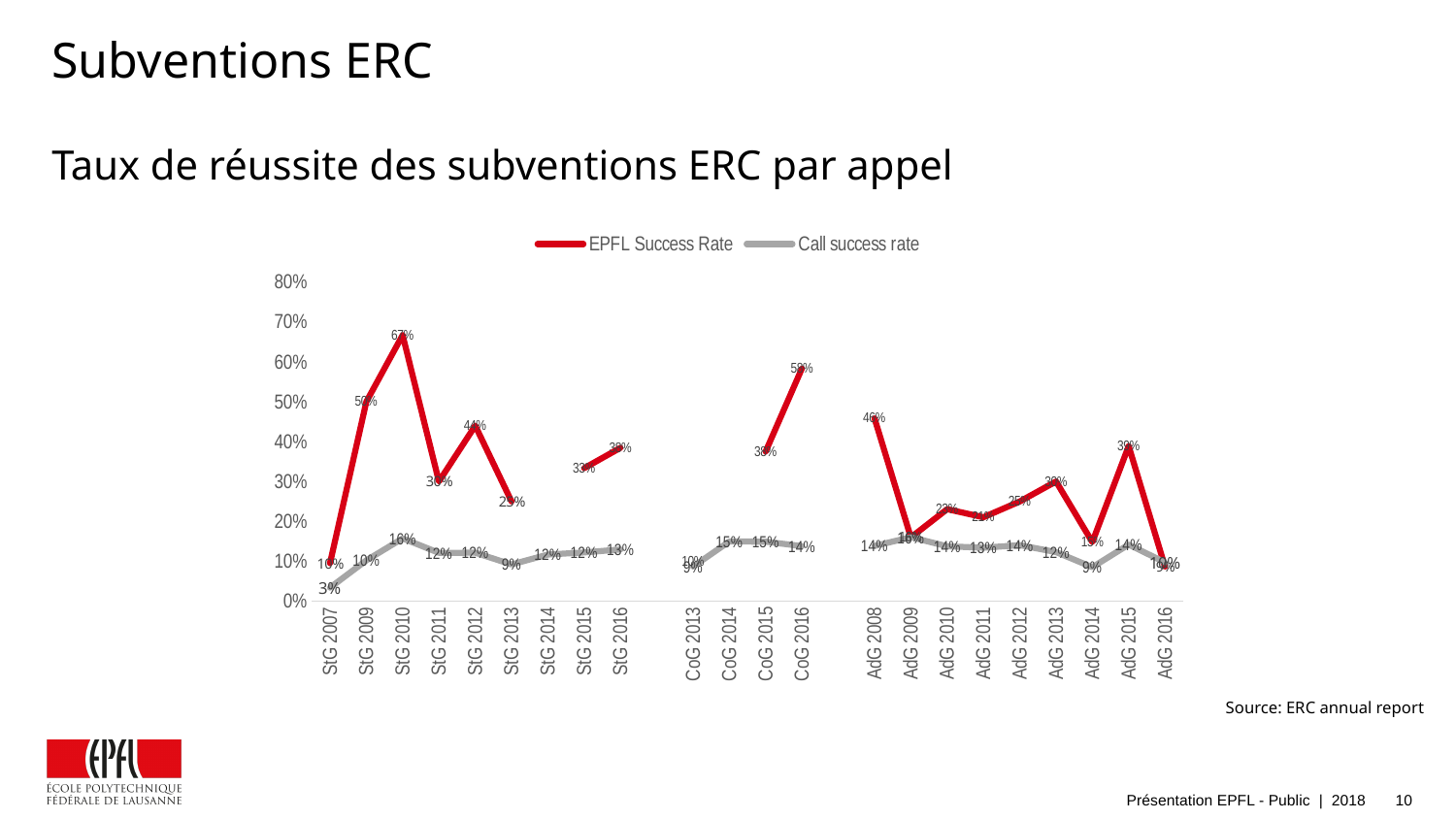
What is the difference between the EPFL Success Rate and the Call success rate for StG 2010? 51 percentage points What is the EPFL Success Rate for CoG 2016? 58% What is the Call success rate for StG 2010? 16% How many calls (categories) are shown on the x axis? 22 What is the EPFL Success Rate for StG 2010? 67% Which call has the highest EPFL Success Rate? StG 2010 What kind of chart is shown on the slide? line chart Which is larger: the EPFL Success Rate for CoG 2016 or for AdG 2008? CoG 2016 Is the EPFL Success Rate for StG 2009 greater or less than 40%? greater What is the Call success rate for StG 2007? 3% Which call has the lowest Call success rate? StG 2007 How many series does the legend list? 2